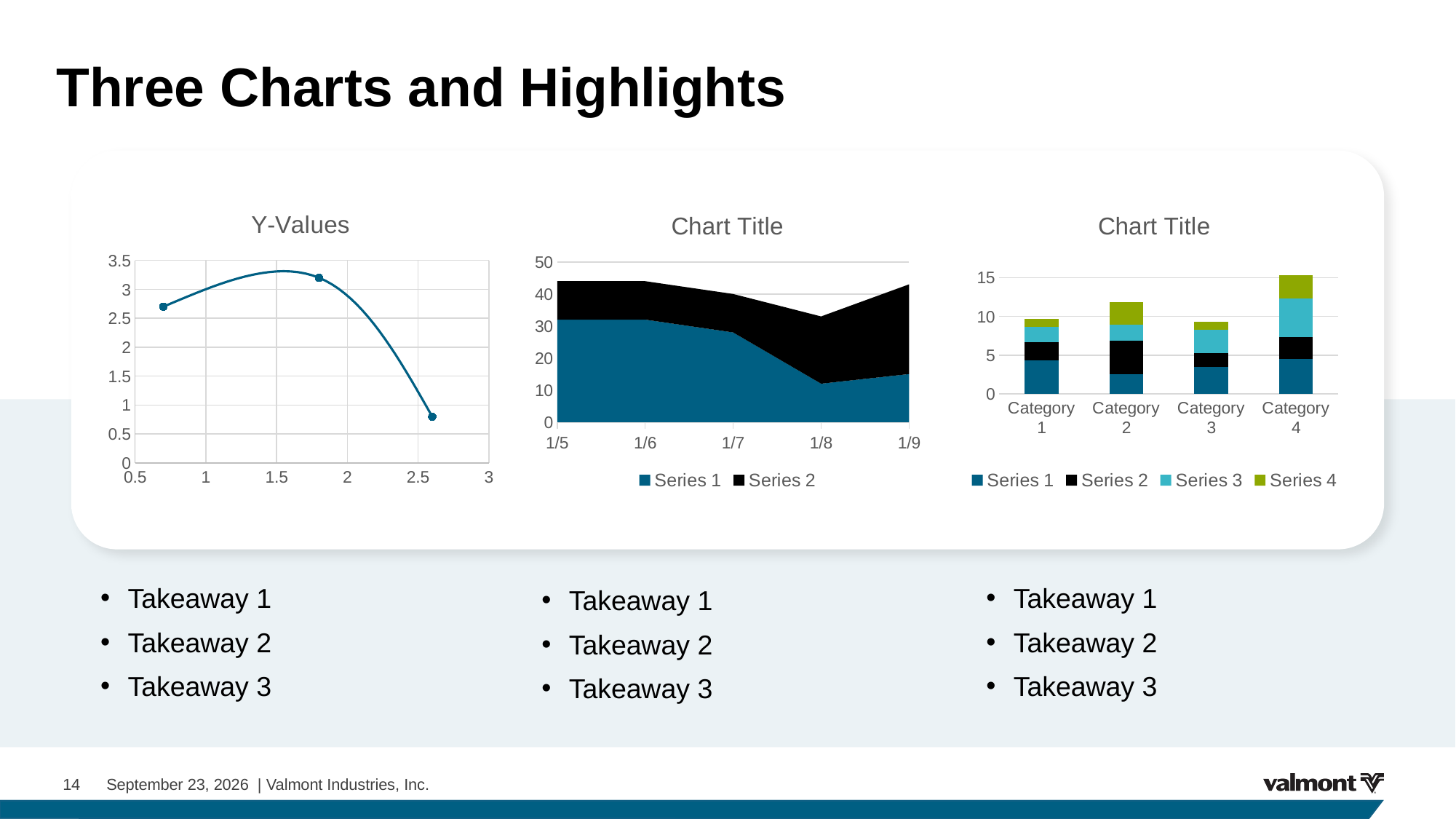
What type of chart is the middle chart? stacked area chart How many series does the legend of the middle chart list? 2 On the middle chart, is the value of Series 1 at 1/8 greater or less than 20? less What type of chart is the right chart? stacked bar chart On the left chart titled "Y-Values", is the value of the rightmost point (near x = 2.6) greater or less than 1? less On the right chart, which category has the tallest stacked bar? Category 4 On the middle chart, at which date is Series 1 lowest? 1/8 On the left chart titled "Y-Values", which point has the lowest y value: the one near x = 0.7, x = 1.8, or x = 2.6? the one near x = 2.6 On the left chart titled "Y-Values", is the value of the middle point (near x = 1.8) greater or less than 3? greater What type of chart is the left chart titled "Y-Values"? scatter chart with a smoothed line How many data points are plotted on the left chart titled "Y-Values"? 3 How many series does the legend of the right chart list? 4